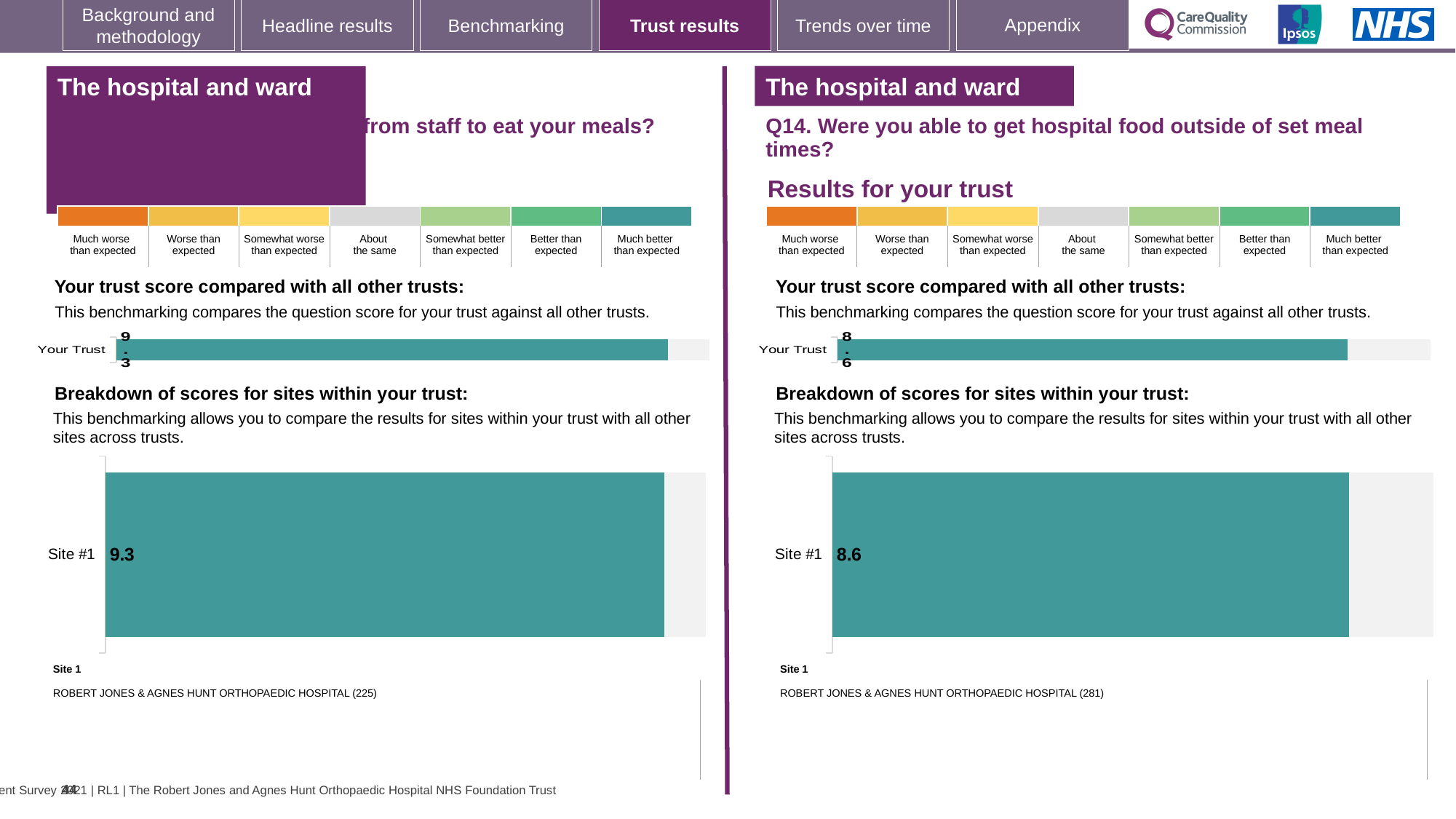
On the left-hand side, what score is shown for Site #1 in the 'Breakdown of scores for sites within your trust' chart? 9.3 On the right-hand side (Q14), what score is shown for Site #1 in the 'Breakdown of scores for sites within your trust' chart? 8.6 How many sites are shown in the 'Breakdown of scores for sites within your trust' chart on the left-hand side? 1 What type of chart is used to show the Your Trust score on the left-hand side? Bar chart On the right-hand side, which hospital is listed as Site 1 below the breakdown chart? ROBERT JONES & AGNES HUNT ORTHOPAEDIC HOSPITAL (281) Which is larger: the Site #1 score on the left-hand chart or the Site #1 score on the right-hand (Q14) chart? The left-hand chart (9.3) On the left-hand side, what is the score shown for Your Trust in the 'Your trust score compared with all other trusts' chart? 9.3 On the right-hand side (Q14), what is the score shown for Your Trust in the 'Your trust score compared with all other trusts' chart? 8.6 What type of chart is used to show the Site #1 score on the right-hand side (Q14)? Bar chart What is the difference between the Site #1 score on the left-hand chart (9.3) and the Site #1 score on the right-hand Q14 chart (8.6)? 0.7 What is the question text shown above the right-hand charts? Q14. Were you able to get hospital food outside of set meal times? How many sites are shown in the 'Breakdown of scores for sites within your trust' chart on the right-hand side (Q14)? 1